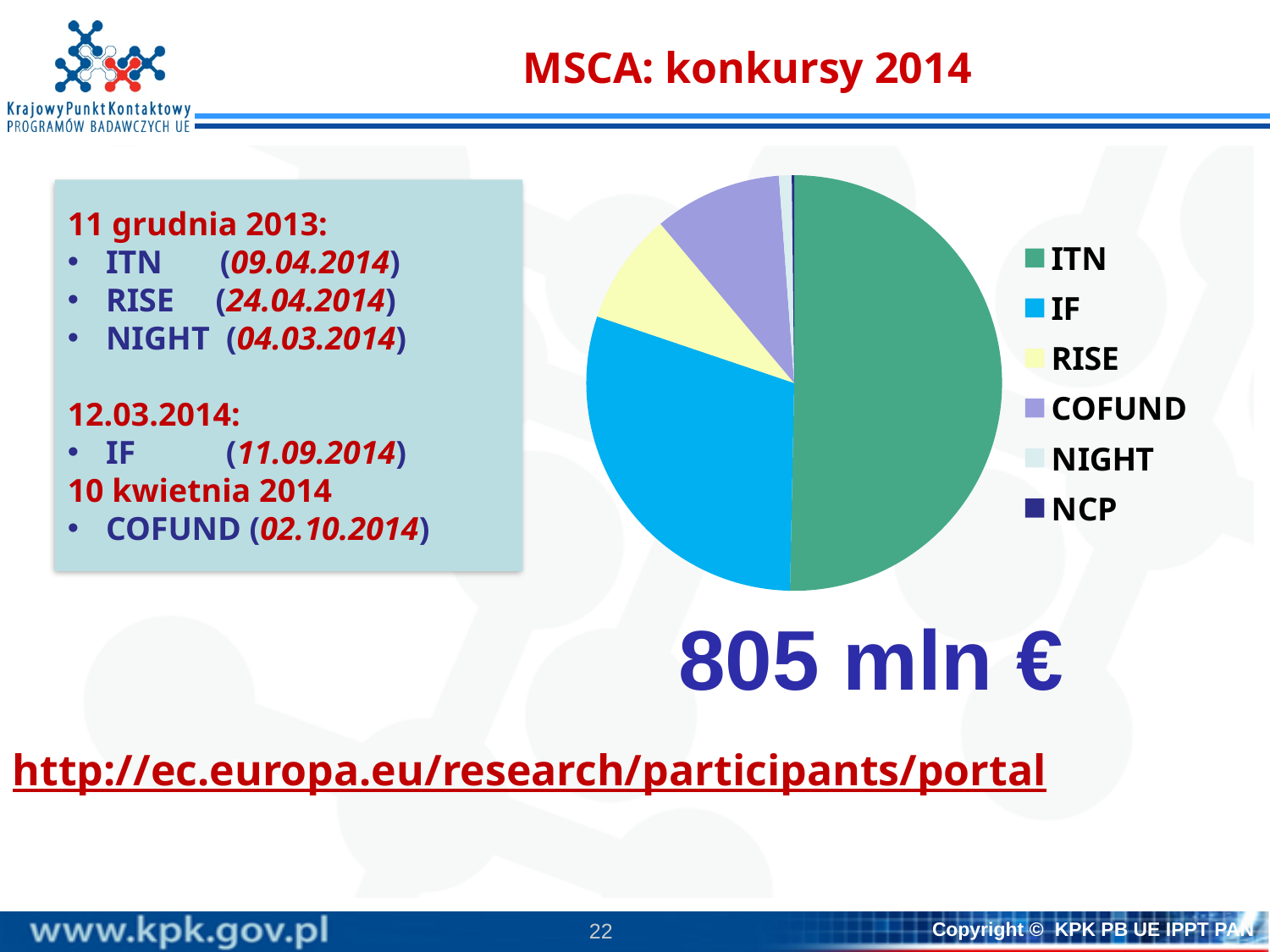
Which slice is larger in the pie chart, ITN or COFUND? ITN Which category has the largest slice of the pie chart? ITN What colour is the IF slice in the pie chart? blue Which slice is larger in the pie chart, IF or COFUND? IF Which category is shown in green in the pie chart? ITN Which slice is larger in the pie chart, ITN or IF? ITN How many categories does the pie chart's legend list? 6 What kind of chart is shown on the slide? pie chart